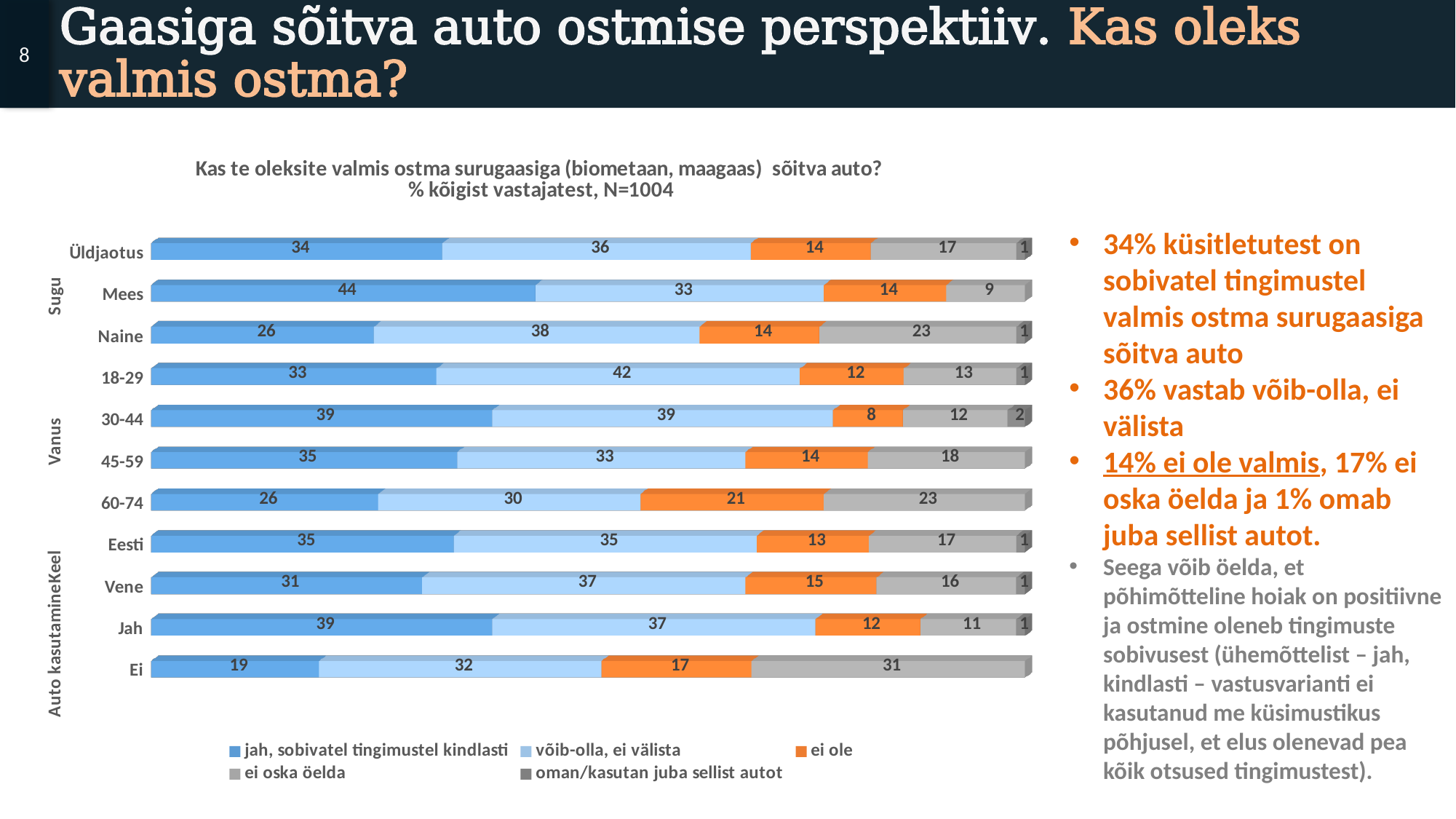
What is the value of "ei ole" for the 60-74 age group? 21 What is the value of "jah, sobivatel tingimustel kindlasti" for Üldjaotus? 34 How many categories (rows) are plotted in the chart? 11 What is the value of "ei oska öelda" for the Ei category? 31 What is the difference between the "jah, sobivatel tingimustel kindlasti" values for Mees and Naine? 18 Which category has the lowest value for "jah, sobivatel tingimustel kindlasti"? Ei What is the N (number of respondents) stated in the chart title? N=1004 Which category has the highest value for "jah, sobivatel tingimustel kindlasti"? Mees What kind of chart is shown on the slide? bar chart What is the total of the stacked bar for the 60-74 age group? 100 Which has a larger "võib-olla, ei välista" value, 18-29 or 60-74? 18-29 How many series does the legend list? 5